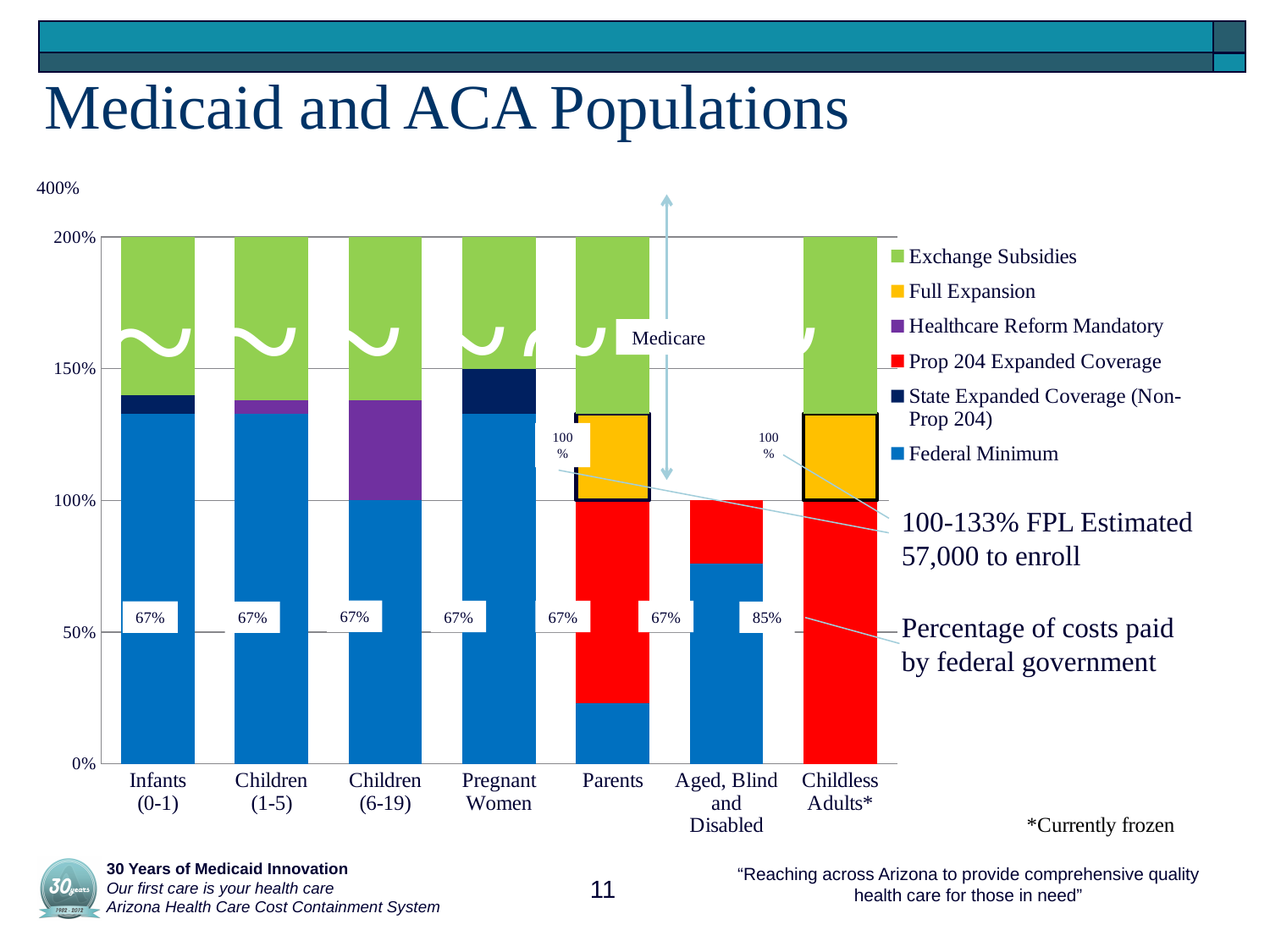
Which is larger, the Federal Minimum value for Aged, Blind and Disabled or the Federal Minimum value for Parents? Aged, Blind and Disabled Is the Federal Minimum value for Infants (0-1) greater or less than 100%? greater How many population categories are shown along the x axis of the chart? 7 What kind of chart is shown on the slide? Stacked bar chart Is the Federal Minimum value for Parents greater or less than 50%? less What is the title of the chart? Medicaid and ACA Populations What percentage of costs paid by the federal government is labelled for the Infants (0-1) category? 67% Which legend entry is shown in yellow? Full Expansion How many series does the chart's legend list? 6